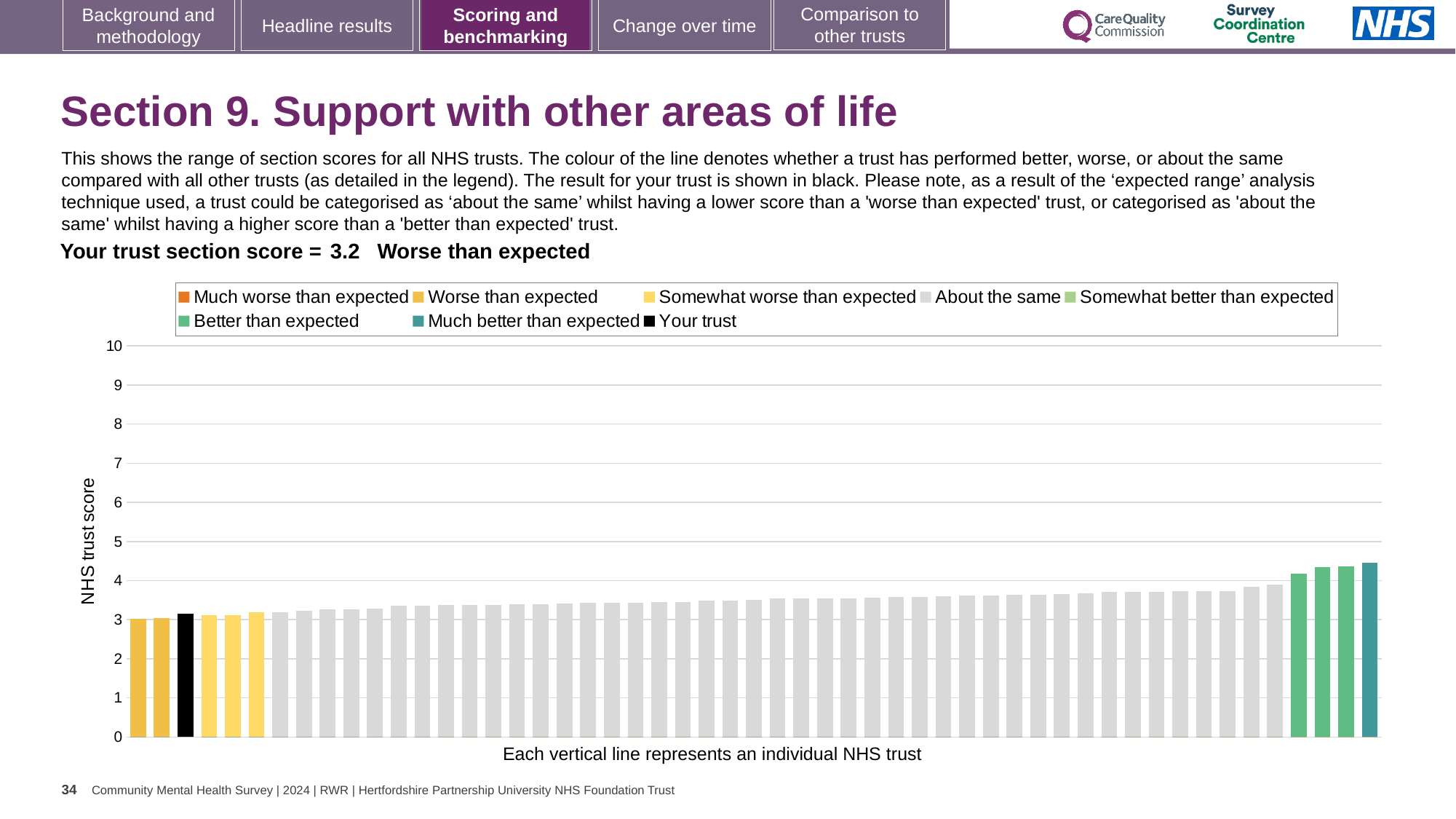
Is the value for your trust greater or less than 4? less What is the section score for your trust shown on the slide? 3.2 What kind of chart is shown on the slide? bar chart What colour is used for the bar representing your trust? black Is the bar for your trust higher or lower than the 'Much better than expected' bar? lower Which performance category is your trust placed in for this section? Worse than expected How many entries does the chart legend list? 8 Which legend category does the tallest bar belong to? Much better than expected What is the label on the vertical axis of the chart? NHS trust score Do the bar values rise or fall from left to right along the x axis? rise How many bars are coloured as 'Better than expected'? 3 Is the tallest bar in the chart greater or less than 4? greater